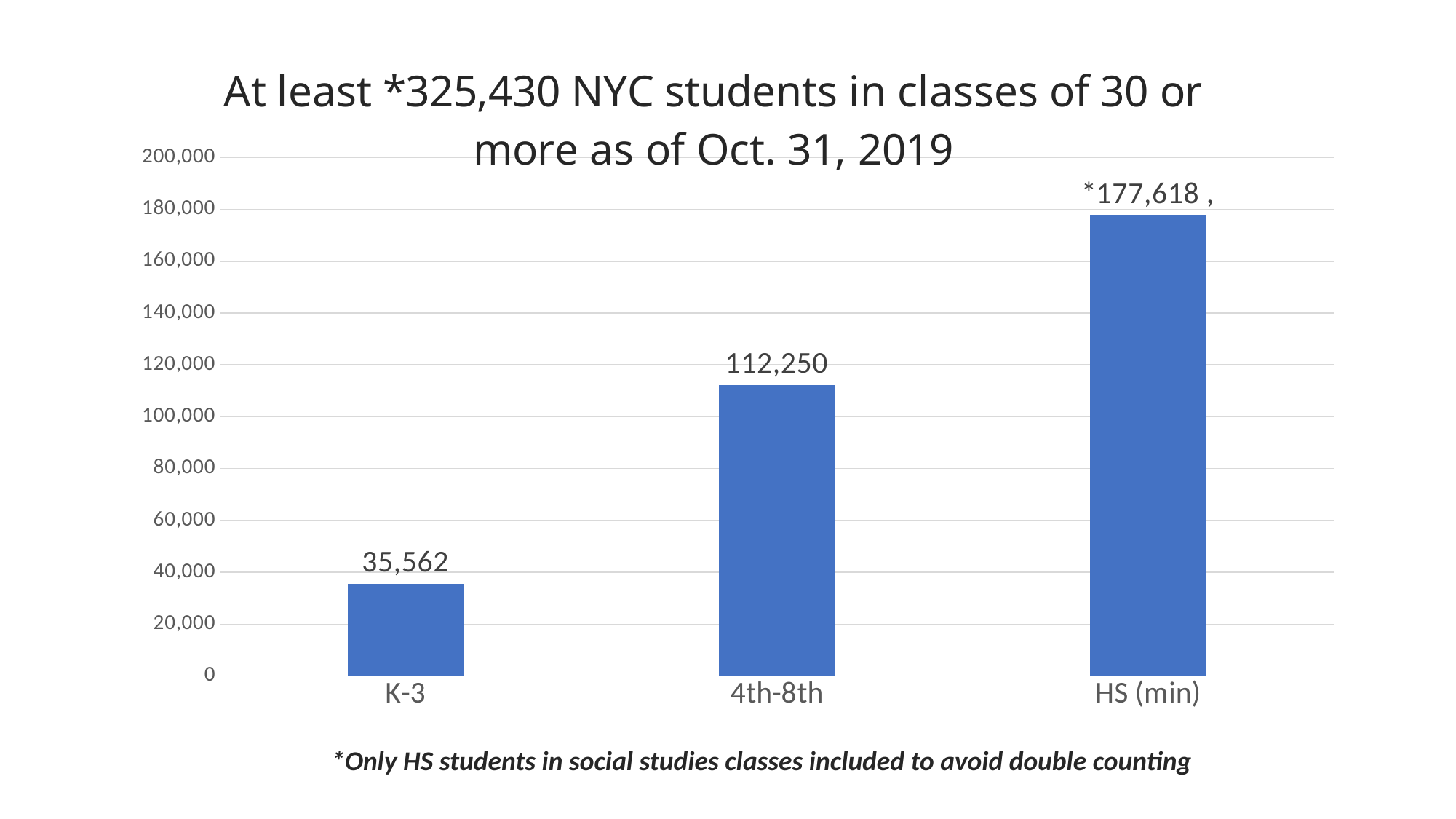
What is the value for 4th-8th? 112,250 What is the value for K-3? 35,562 Which category has the lowest value? K-3 What is the difference between the values for HS (min) and 4th-8th? 65,368 What is the difference between the values for 4th-8th and K-3? 76,688 What is the value for HS (min)? 177,618 What kind of chart is this? bar chart What is the title of the chart? At least *325,430 NYC students in classes of 30 or more as of Oct. 31, 2019 Is the value for 4th-8th greater or less than 100,000? greater How many categories are shown on the x axis? 3 Which category has the highest value? HS (min) Which is larger, the value for 4th-8th or the value for K-3? 4th-8th